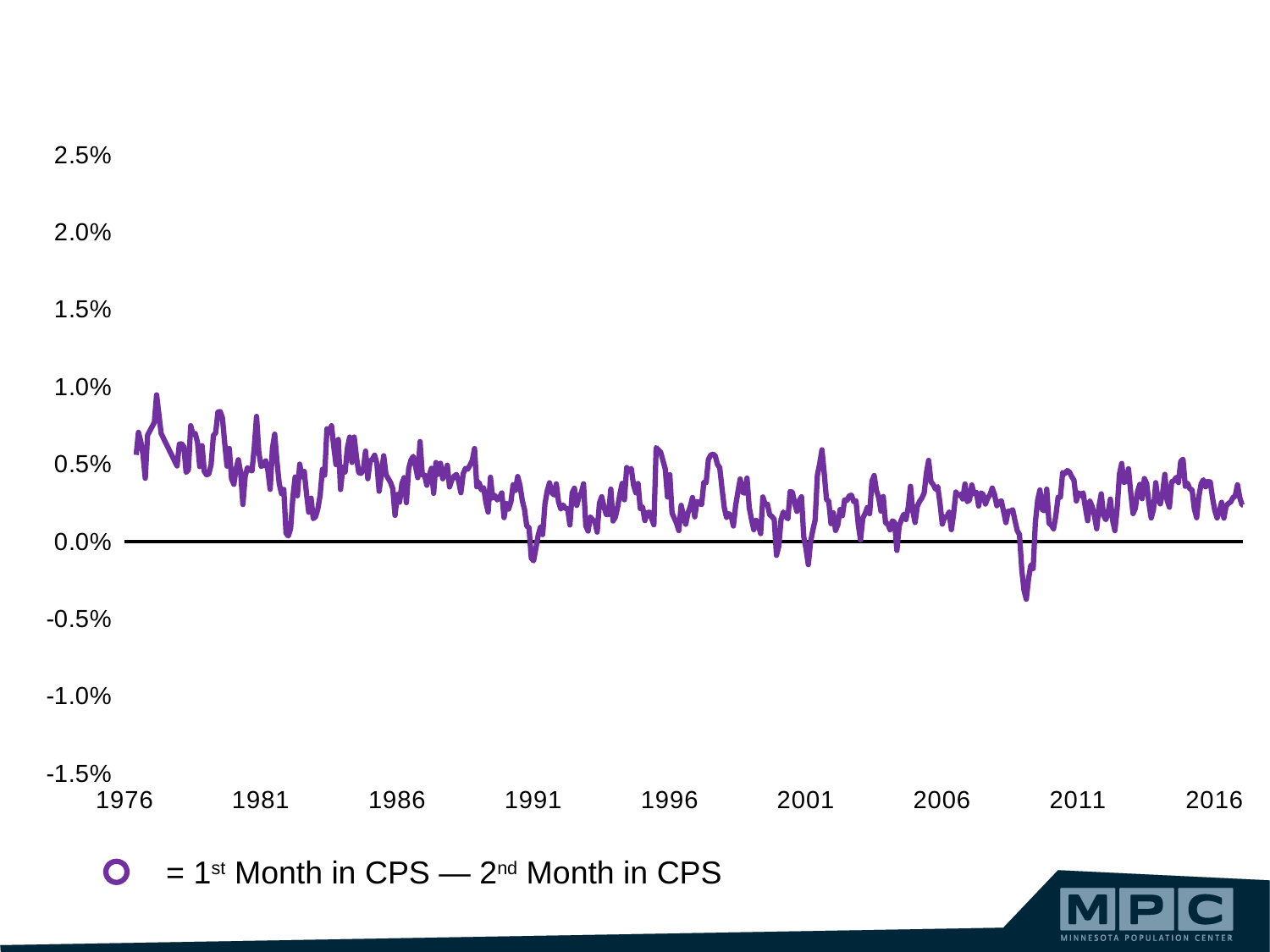
How many series does the legend list? 1 How many year labels are shown on the x axis? 9 Is the value at the start of the series in 1976 greater or less than 0.0%? greater Is the value at the end of the series in 2016 greater or less than 1.0%? less What is the first year labelled on the x axis? 1976 What kind of chart is shown on the slide? line chart Is the lowest value reached by the line greater or less than -0.5%? greater What is the last year labelled on the x axis? 2016 What is the highest value labelled on the y axis? 2.5% Overall, do the values rise or fall from 1976 to 2016? fall What does the legend say the plotted series represents? 1st Month in CPS — 2nd Month in CPS